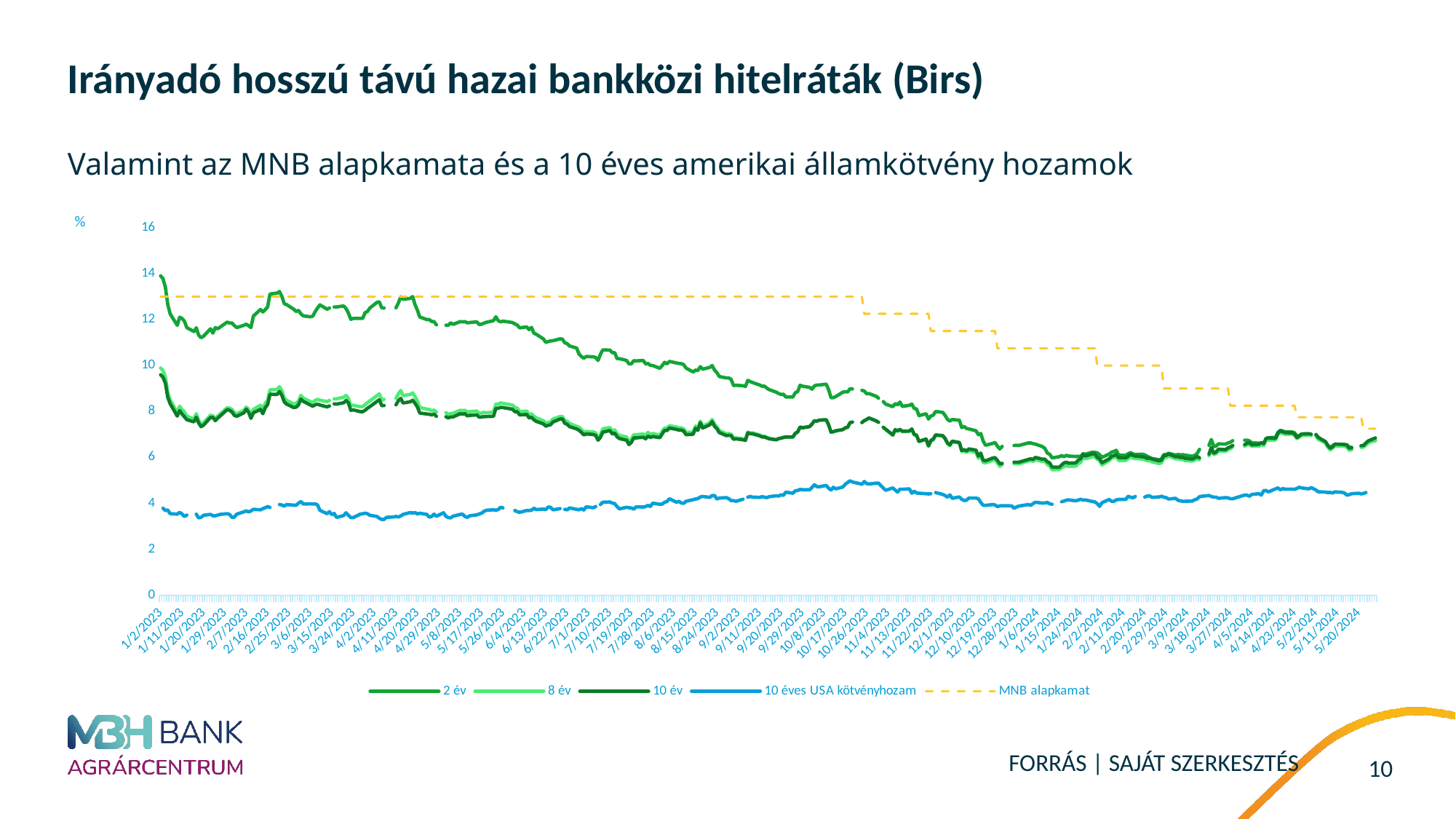
What unit is shown on the vertical axis? % Is the value of the 2 év series at 1/2/2023 greater or less than 12? greater Which series has the lowest value at 5/20/2024? 10 éves USA kötvényhozam Which series is drawn as a dashed line? MNB alapkamat Does the MNB alapkamat series rise or fall over the period shown? fall How many series does the legend list? 5 What kind of chart is shown on the slide? line chart Is the value of the 10 éves USA kötvényhozam series at 5/20/2024 greater or less than 6? less Does the 2 év series rise or fall over the period from 1/2/2023 to 5/20/2024? fall At 1/2/2023, which is larger: the 2 év series or the 10 éves USA kötvényhozam series? 2 év Is the value of MNB alapkamat at 1/2/2023 greater or less than 12? greater